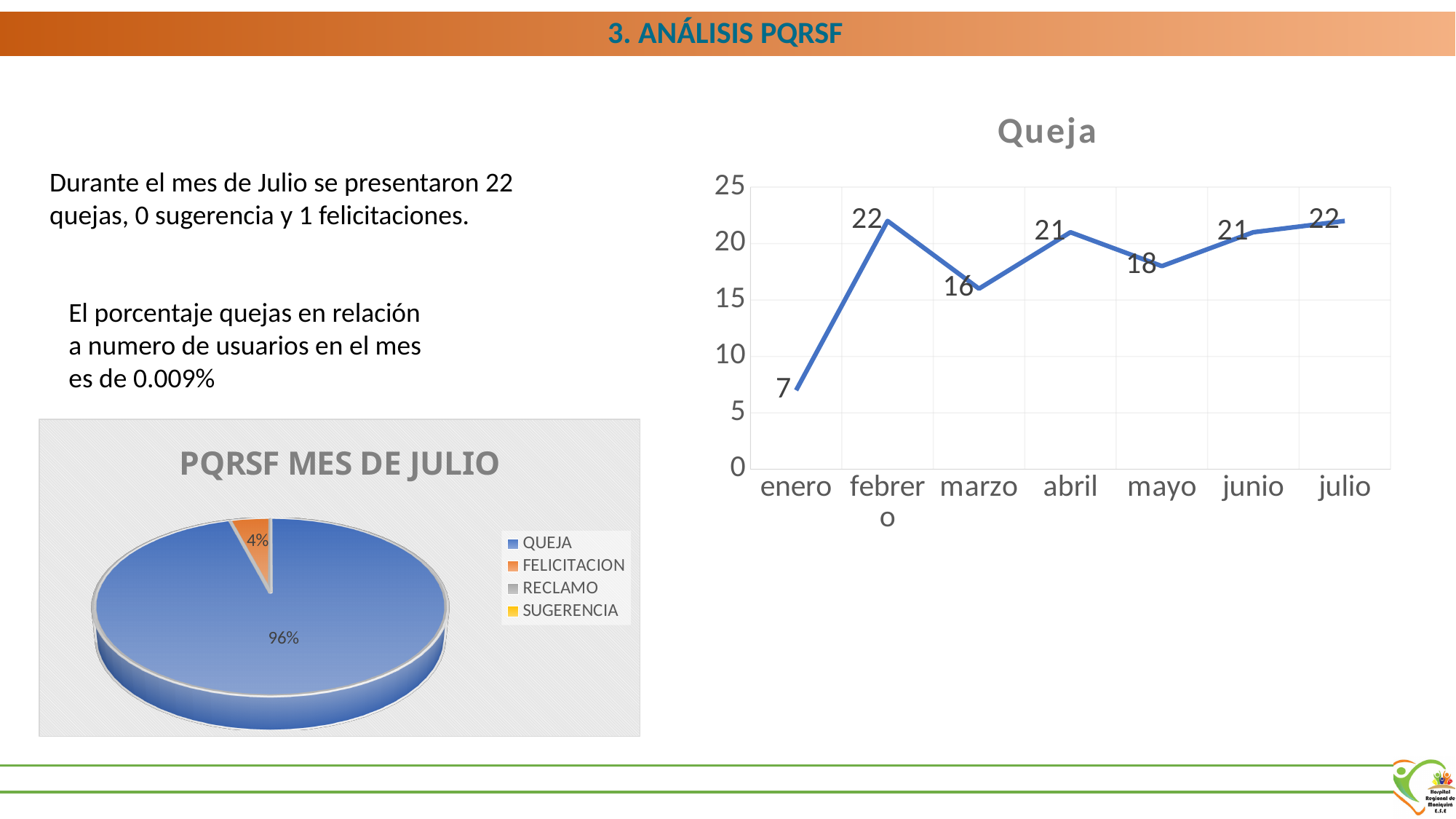
In the 'PQRSF MES DE JULIO' chart, what share of the pie is FELICITACION? 4% In the 'Queja' chart, what is the value for marzo? 16 In the 'Queja' chart, does the value rise or fall from enero to febrero? rise In the 'Queja' chart, what is the value for mayo? 18 What kind of chart is the 'Queja' chart? line chart In the 'Queja' chart, what is the difference between the values for febrero and marzo? 6 In the 'Queja' chart, which is larger, the value for abril or the value for mayo? abril How many entries does the legend of the 'PQRSF MES DE JULIO' chart list? 4 In the 'Queja' chart, which month has the lowest value? enero In the 'Queja' chart, how many months are plotted on the x axis? 7 In the 'Queja' chart, what is the value for enero? 7 In the 'PQRSF MES DE JULIO' chart, what share of the pie is QUEJA? 96%